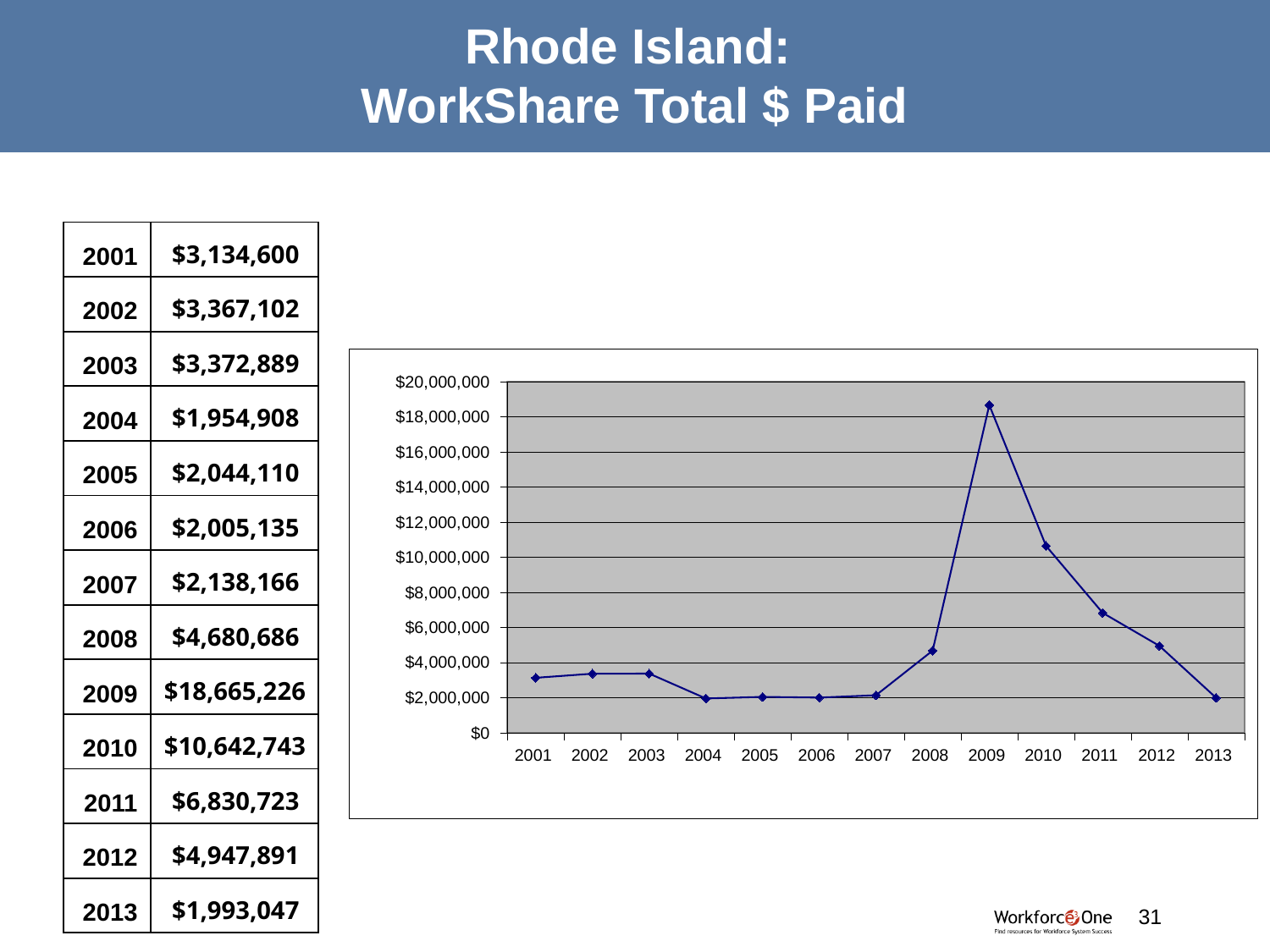
Which is larger, the total paid in 2011 or in 2012? 2011 Is the value for 2010 greater or less than $10,000,000? greater How many years are plotted on the chart? 13 What is the difference between the total paid in 2009 and in 2010? $8,022,483 What was the WorkShare total paid in 2001? $3,134,600 What kind of chart is shown on the slide? line chart Which year has the highest WorkShare total paid? 2009 Is the value for 2011 greater or less than $8,000,000? less Do the values rise or fall from 2009 to 2013? fall What was the WorkShare total paid in 2013? $1,993,047 What was the WorkShare total paid in 2009? $18,665,226 Which year has the lowest WorkShare total paid? 2004